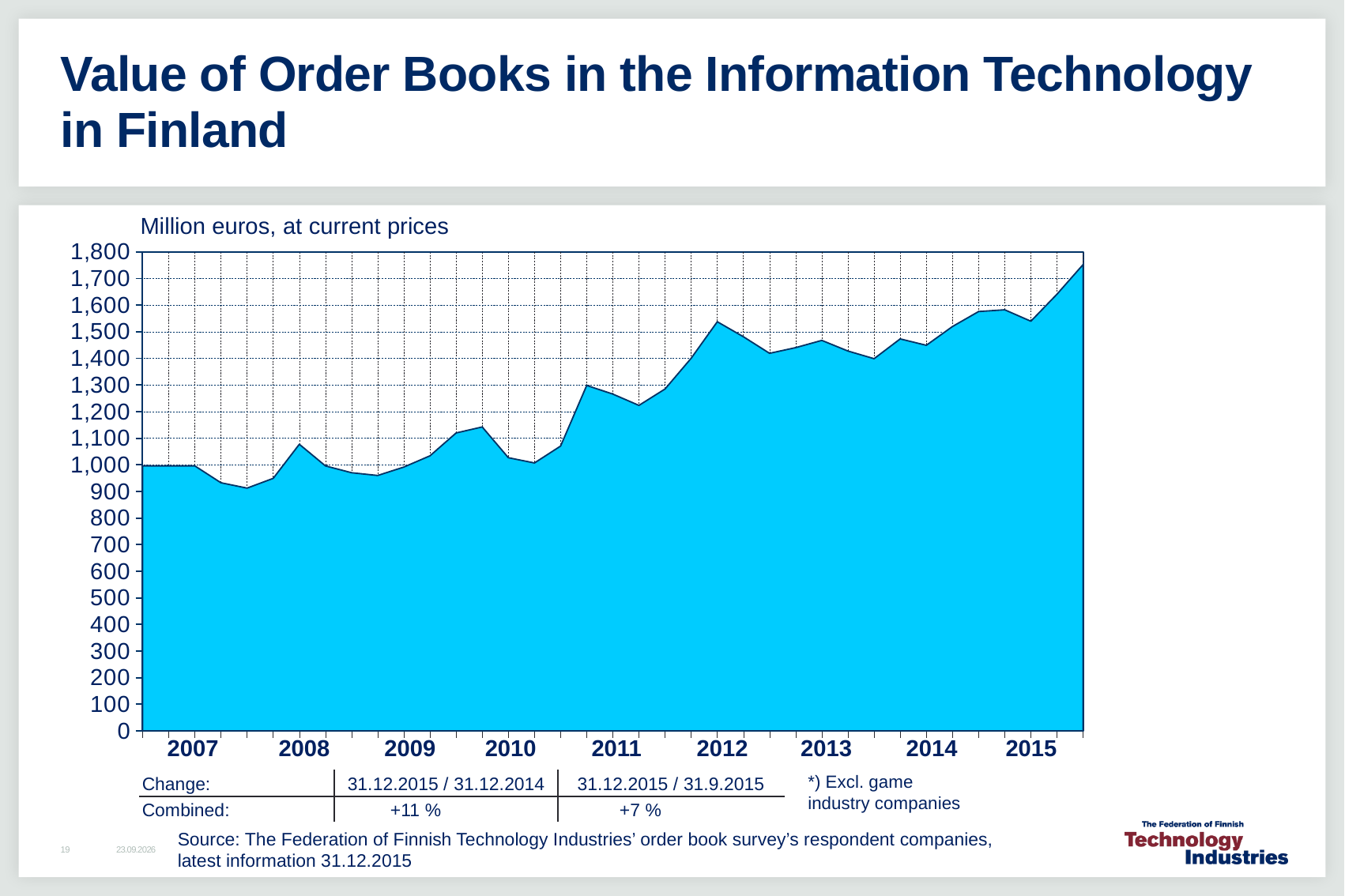
How many years are labelled on the x axis of the chart? 9 Is the value at the end of 2015 greater or less than 1,500? greater Which year is labelled first on the x axis? 2007 Is the peak value in 2012 greater or less than 1,400? greater Is the lowest value in 2007 greater or less than 1,000? less Is the value at the end of 2015 larger or smaller than the value at the start of 2007? larger In which year does the chart reach its highest value? 2015 Overall, do the values rise or fall from 2007 to 2015? Rise What unit is the value of order books measured in, according to the chart? Million euros, at current prices In which year does the chart reach its lowest value? 2007 What type of chart is shown on the slide? Area chart